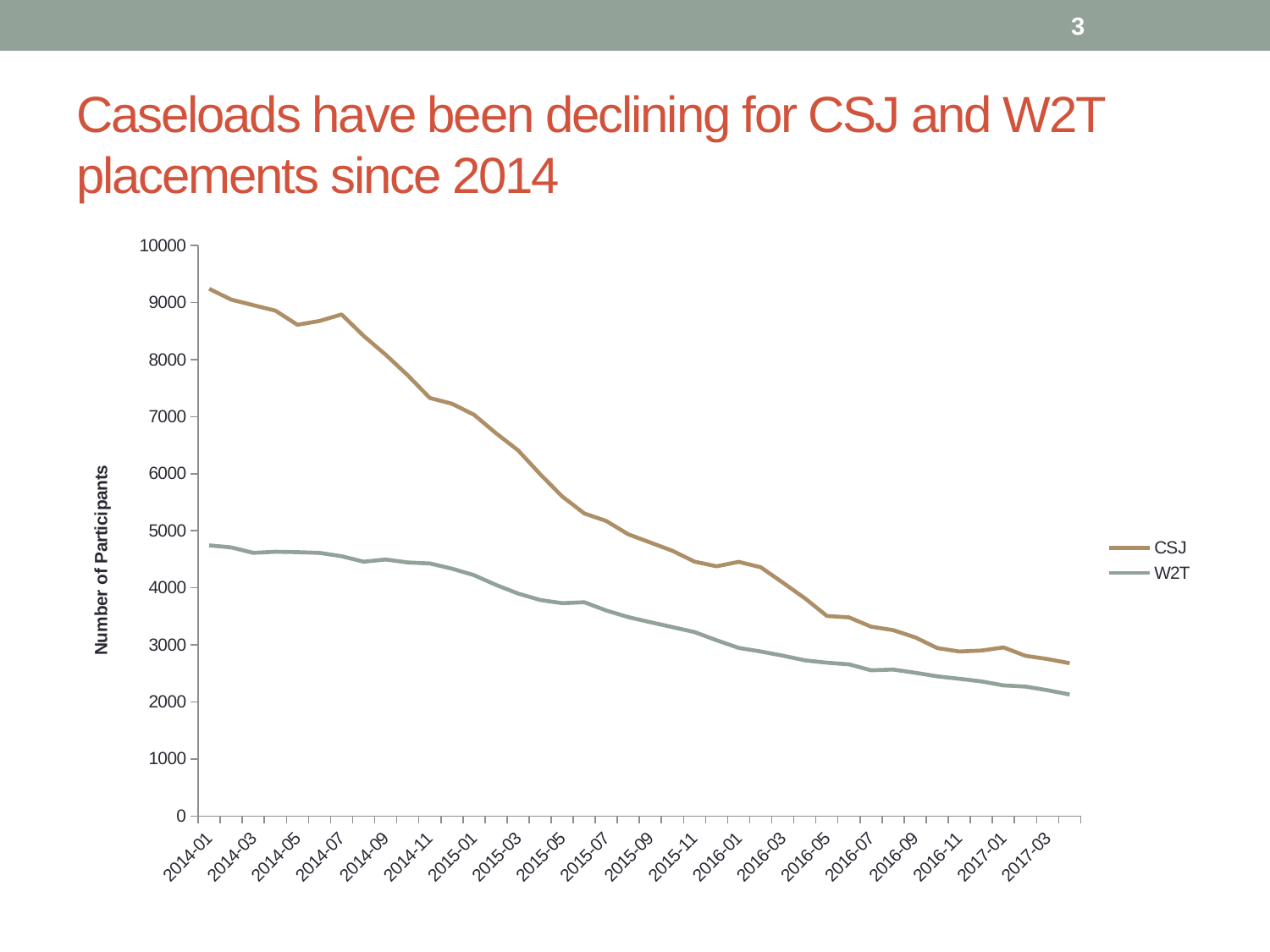
What is the label on the vertical axis? Number of Participants Which series has the lower value at 2017-03, CSJ or W2T? W2T Is the CSJ value at 2014-01 greater or less than 9000? greater What kind of chart is shown on the slide? line chart Is the W2T value at 2014-01 greater or less than 5000? less Which series has the higher value at 2014-01, CSJ or W2T? CSJ How many series does the legend list? 2 Do the W2T values rise or fall from 2014-01 to 2017-03? fall Do the CSJ values rise or fall from 2014-01 to 2017-03? fall Is the CSJ value at 2017-03 greater or less than 3000? less Which two series are listed in the legend? CSJ and W2T